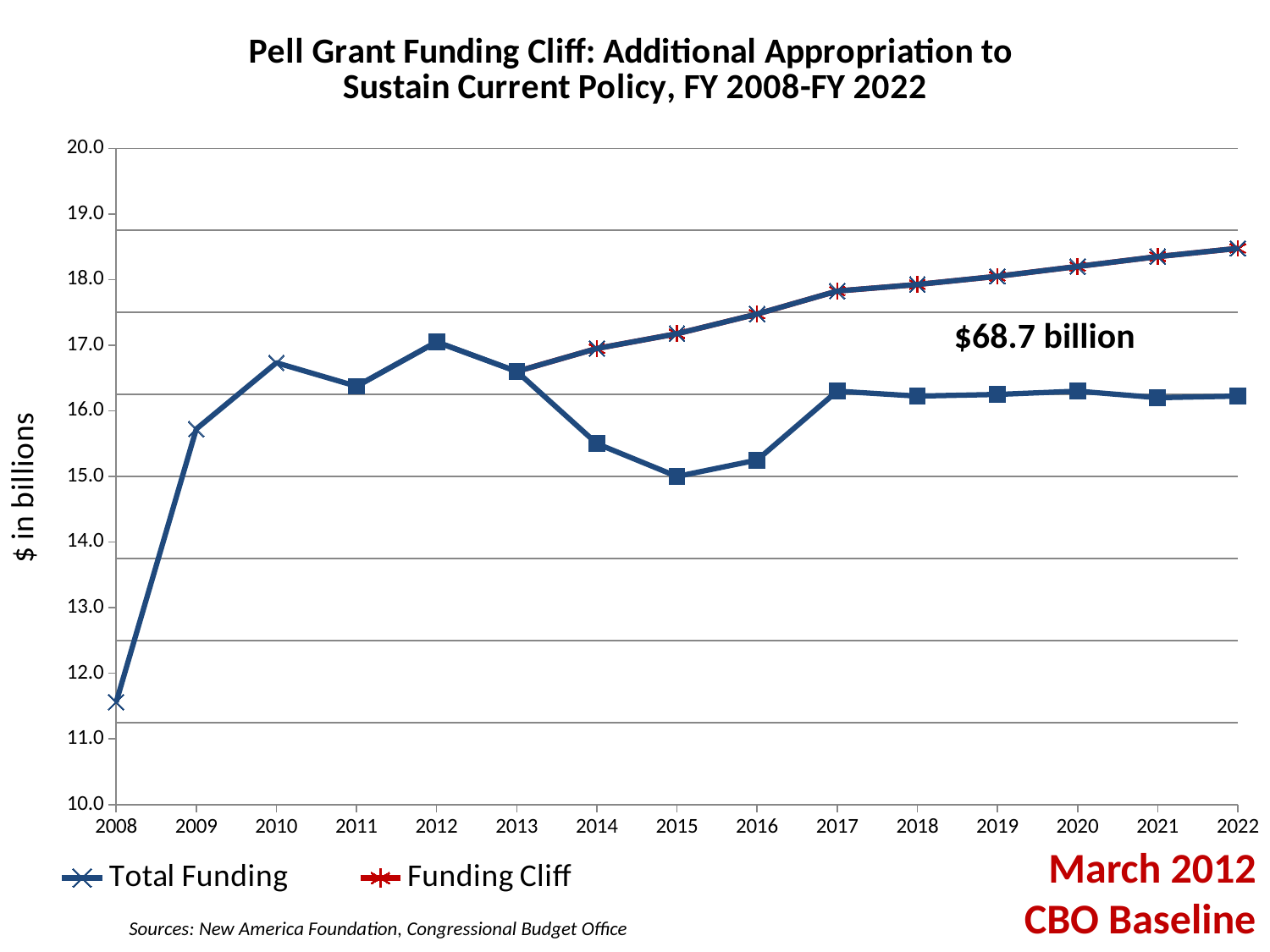
Is the Total Funding value for 2008 greater or less than 12.0? less What kind of chart is shown on the slide? Line chart In which year is the Funding Cliff series highest? 2022 How many series does the legend list? 2 Is the Funding Cliff value for 2022 greater or less than 18.0? greater What dollar amount is annotated on the chart between the two lines? $68.7 billion In which year is Total Funding lowest? 2008 How many years are shown along the x axis? 15 Does the Funding Cliff series rise or fall from 2014 to 2022? Rise